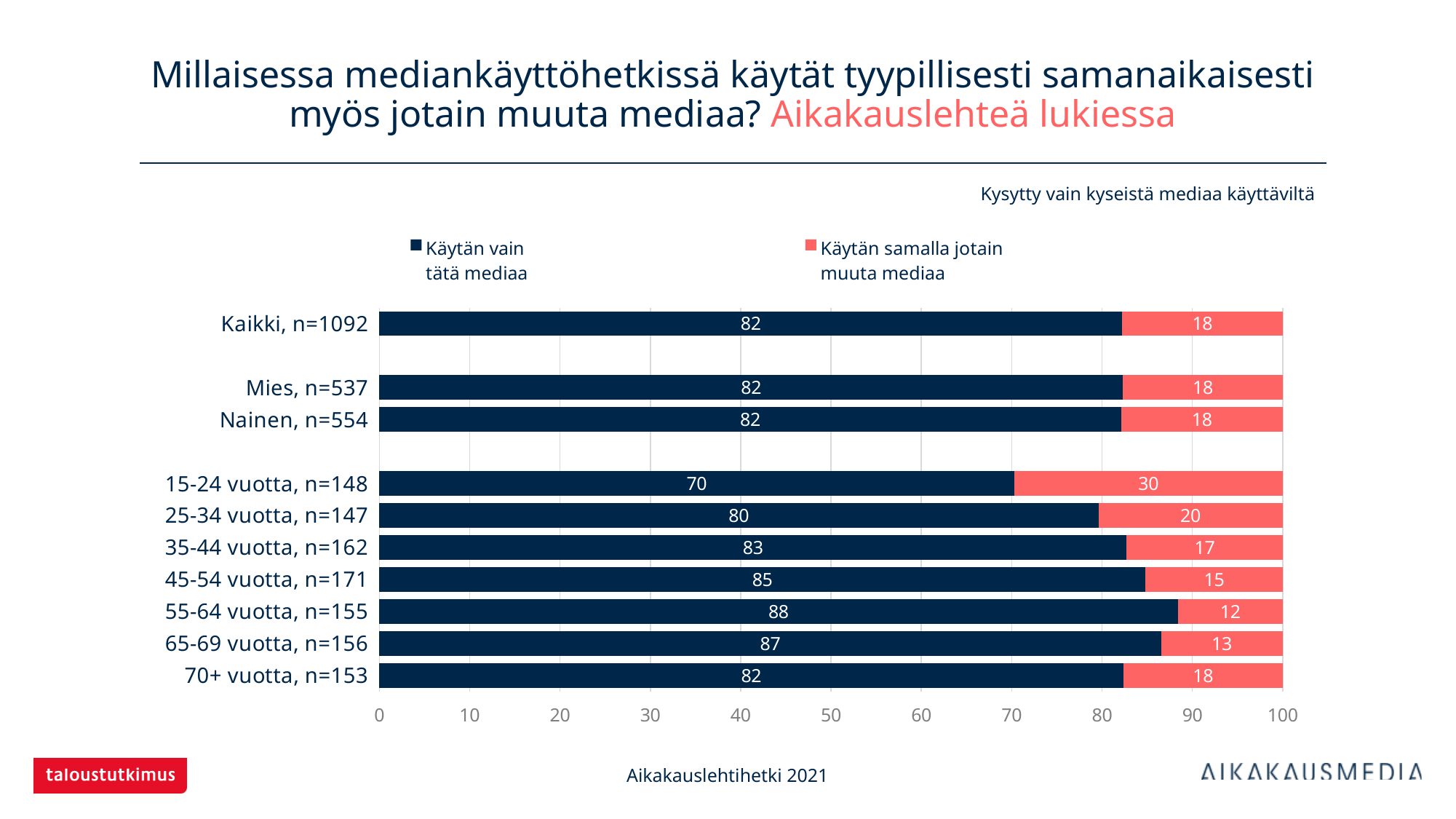
What is the difference between the "Käytän samalla jotain muuta mediaa" values for 15-24 vuotta, n=148 and 55-64 vuotta, n=155? 18 What is the value of "Käytän vain tätä mediaa" for Kaikki, n=1092? 82 How many series does the legend list? 2 Which colour represents the series "Käytän samalla jotain muuta mediaa"? Red What is the total of the stacked bar for 65-69 vuotta, n=156? 100 Which is larger: the "Käytän vain tätä mediaa" value for 45-54 vuotta, n=171 or for 25-34 vuotta, n=147? 45-54 vuotta, n=171 What kind of chart is shown on the slide? Stacked bar chart What is the value of "Käytän vain tätä mediaa" for 55-64 vuotta, n=155? 88 Which category has the lowest value for "Käytän vain tätä mediaa"? 15-24 vuotta, n=148 How many categories are shown on the chart? 10 What is the value of "Käytän samalla jotain muuta mediaa" for 15-24 vuotta, n=148? 30 Which category has the highest value for "Käytän samalla jotain muuta mediaa"? 15-24 vuotta, n=148